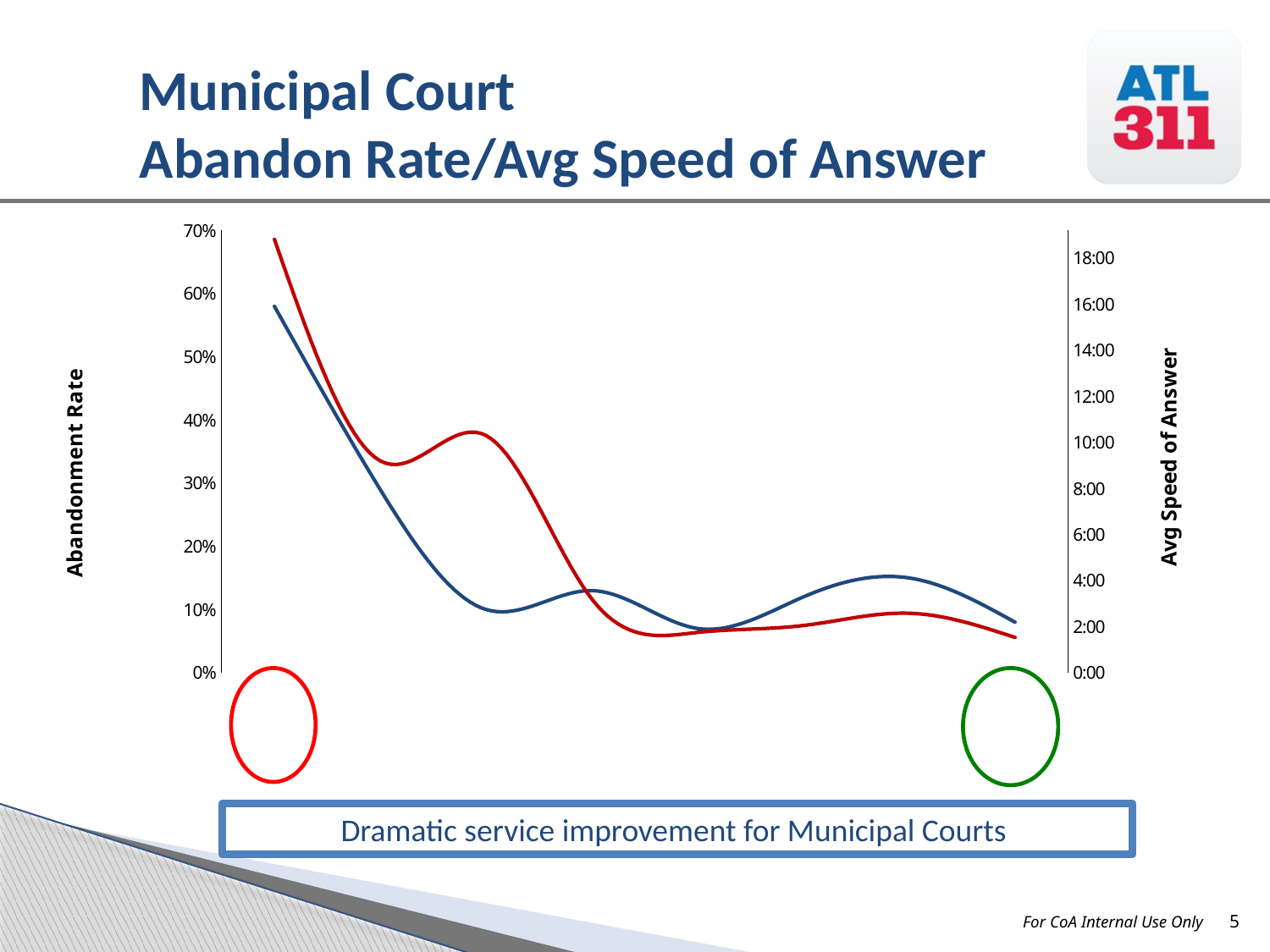
Read against the left axis, is the ending value of the red line at the right end of the chart greater or less than 20%? less What kind of chart is shown on the slide? line chart Overall, does the red line rise or fall from left to right across the chart? fall How many lines are plotted on the chart? 2 Overall, does the blue line rise or fall from left to right across the chart? fall What is the title of the left vertical axis? Abandonment Rate At the right end of the chart, which line is higher, the red line or the blue line? blue line Read against the left axis, is the starting value of the blue line at the left end of the chart greater or less than 50%? greater At the left end of the chart, which line is higher, the red line or the blue line? red line Read against the left axis, is the ending value of the blue line at the right end of the chart greater or less than 20%? less What is the title of the right vertical axis? Avg Speed of Answer